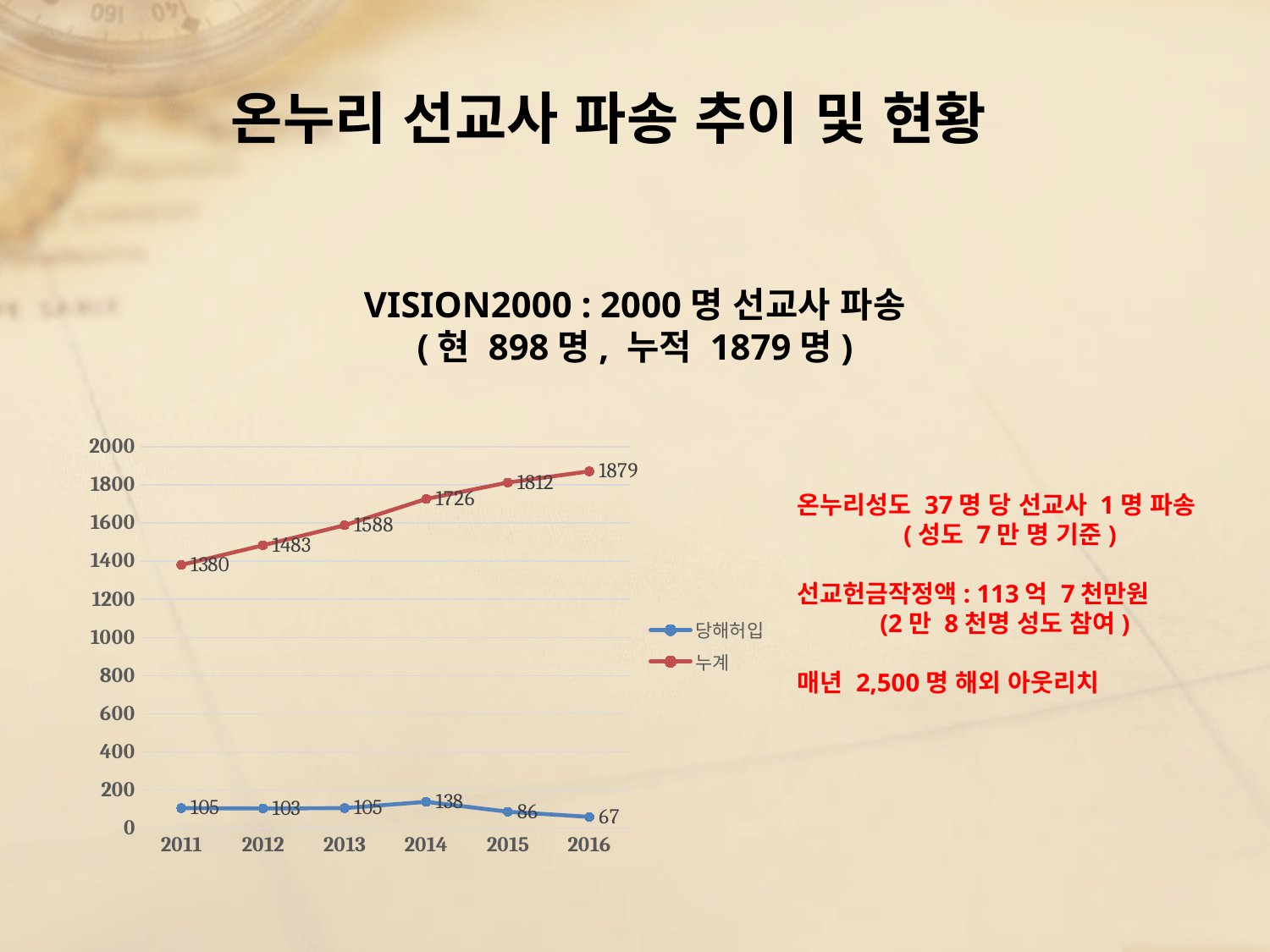
What is the value of 누계 in 2011? 1380 Is the value of 누계 in 2013 greater or less than 1400? greater What kind of chart is shown on the slide? line chart How many years are shown on the x axis of the chart? 6 Which is larger, 당해허입 in 2011 or 당해허입 in 2012? 2011 In which year is 당해허입 lowest? 2016 What is the value of 누계 in 2016? 1879 How many series does the chart legend list? 2 In which year is 당해허입 highest? 2014 What is the difference between 당해허입 in 2014 and 당해허입 in 2015? 52 What is the value of 당해허입 in 2014? 138 What is the difference between 누계 in 2016 and 누계 in 2015? 67